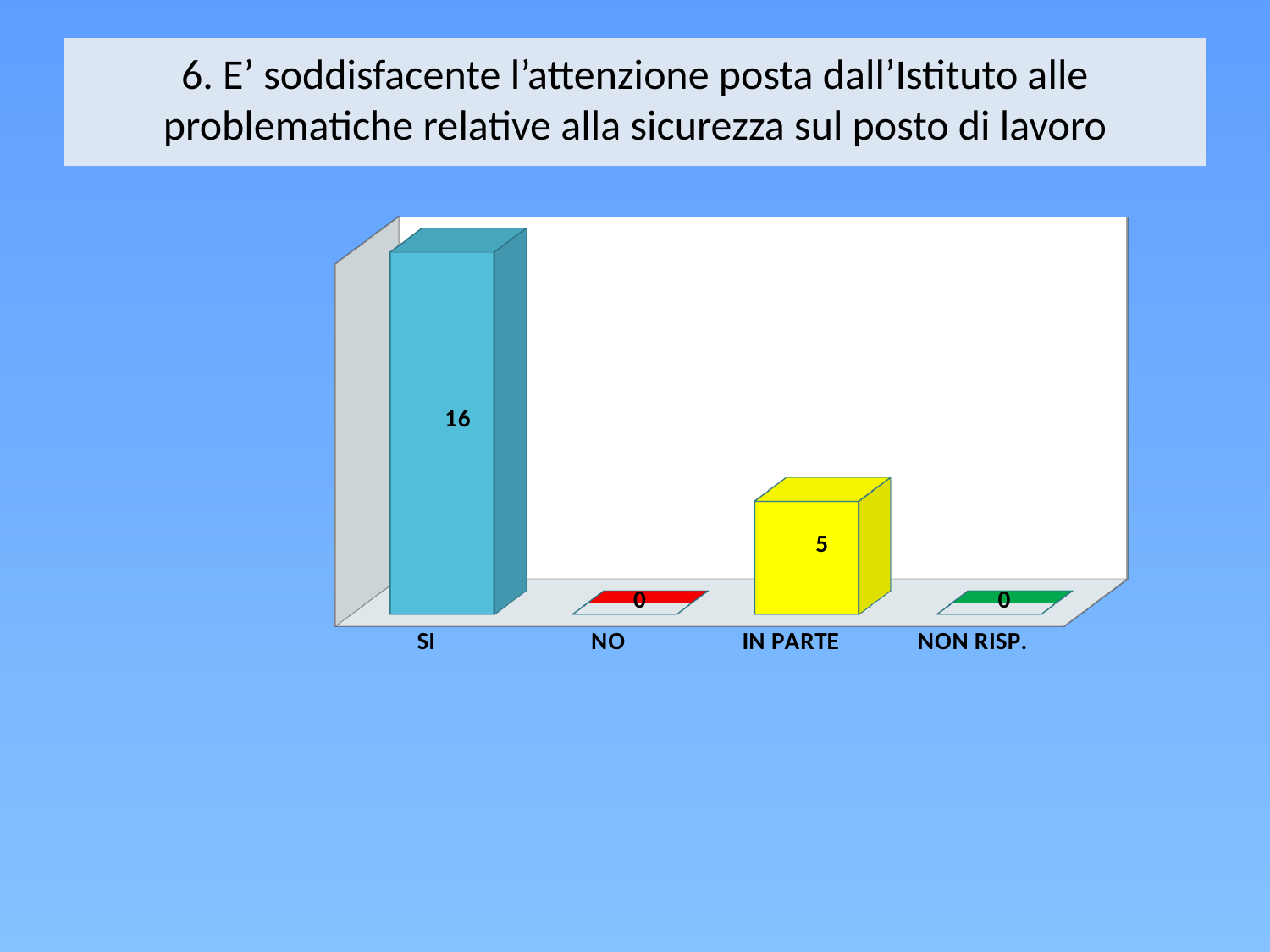
What colour is the bar for IN PARTE? yellow Which is larger, the value for SI or the value for IN PARTE? SI What is the value for NON RISP.? 0 What is the difference between the values for SI and IN PARTE? 11 How many categories are shown on the x axis? 4 What colour is the bar for SI? blue What is the total of all the values shown in the chart? 21 What is the value for IN PARTE? 5 What is the value for SI? 16 What is the value for NO? 0 Which category has the highest value? SI What kind of chart is shown on the slide? bar chart